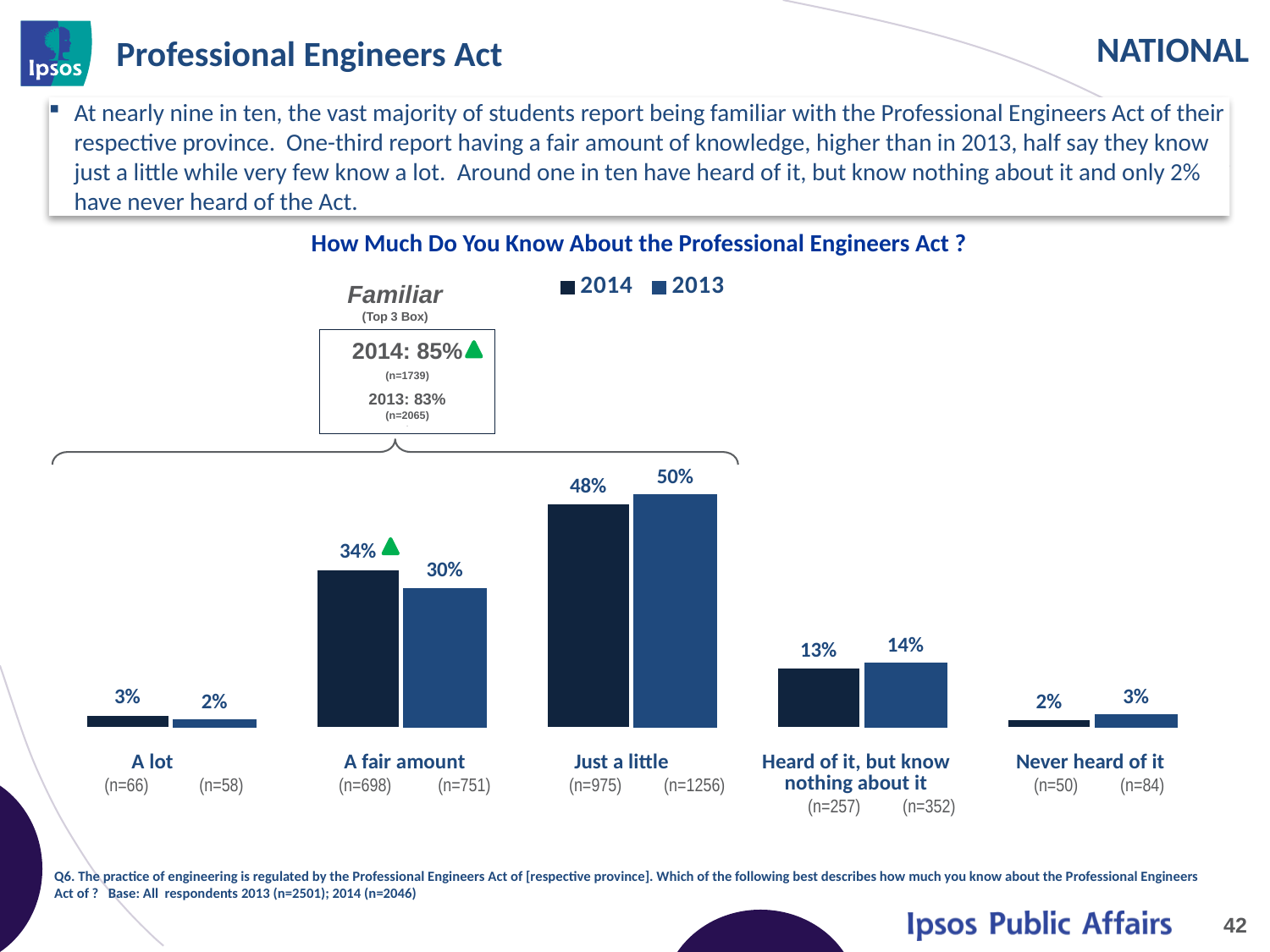
What percentage in 2014 said they had 'Never heard of it'? 2% What was the 2013 value for 'Just a little'? 50% What is the 'Familiar (Top 3 Box)' value for 2014 shown in the callout box? 85% How many series does the legend list? 2 What percentage of respondents in 2014 said they know 'A fair amount' about the Professional Engineers Act? 34% What type of chart is shown on the slide? Bar chart What is the title of the chart? How Much Do You Know About the Professional Engineers Act ? For 'Heard of it, but know nothing about it', which year has the larger value, 2014 or 2013? 2013 Which category has the highest value for the 2014 series? Just a little Which category has the lowest value for the 2013 series? A lot What is the difference between the 2014 and 2013 values for 'A fair amount'? 4 percentage points How many response categories are shown on the x axis? 5